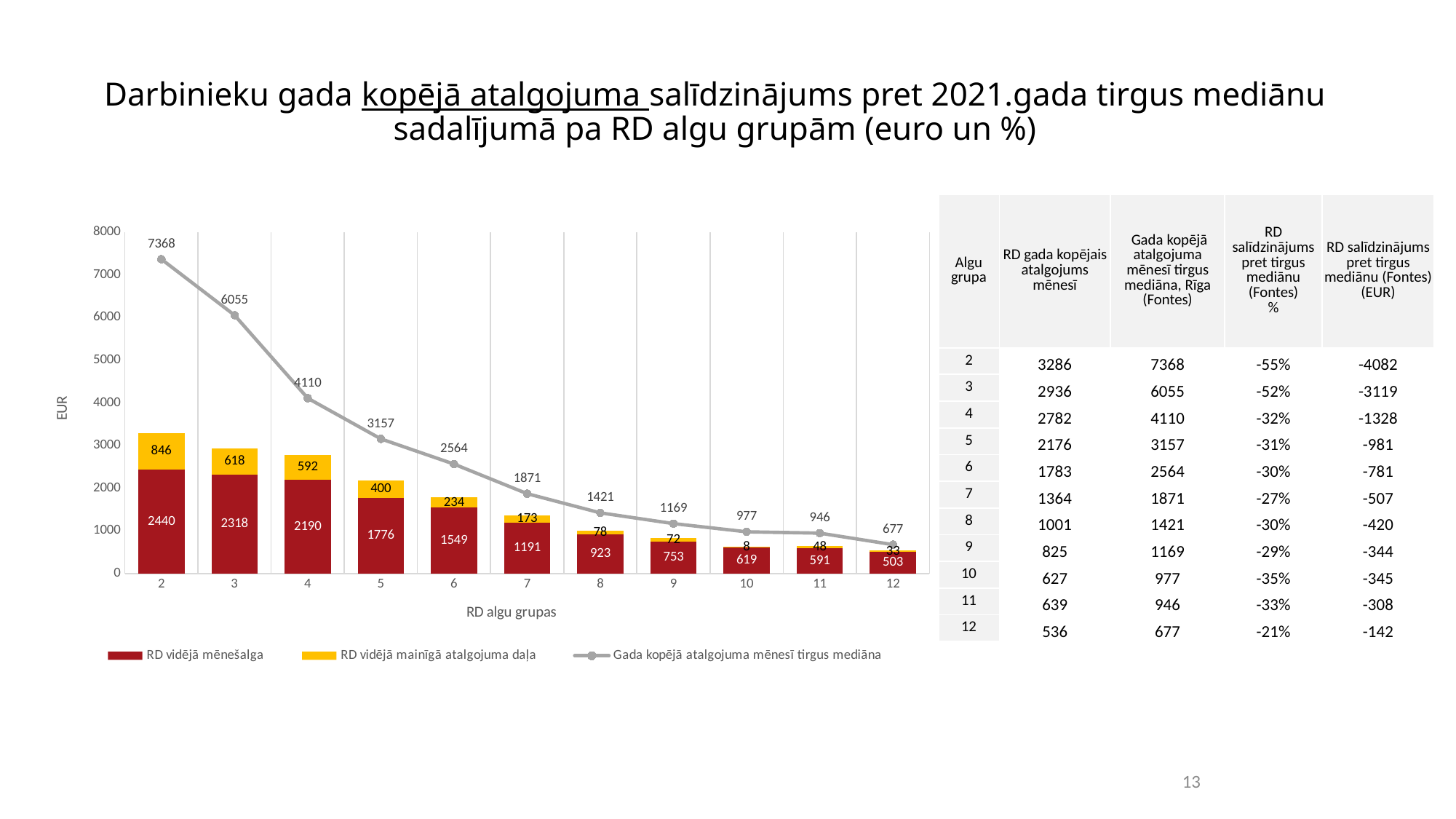
Does the Gada kopējā atalgojuma mēnesī tirgus mediāna rise or fall as the RD algu grupa number increases? fall What is the Gada kopējā atalgojuma mēnesī tirgus mediāna for RD algu grupa 7? 1871 What is the value of RD vidējā mainīgā atalgojuma daļa for RD algu grupa 4? 592 How many RD algu grupas are shown on the x axis of the chart? 11 What is the difference between the Gada kopējā atalgojuma mēnesī tirgus mediāna for grupa 2 and grupa 3? 1313 Which RD algu grupa has the lowest RD vidējā mēnešalga? 12 What is the total of the stacked bar for RD algu grupa 2? 3286 Which is larger, the RD vidējā mainīgā atalgojuma daļa for grupa 3 or for grupa 4? grupa 3 What kind of chart is shown on the slide? stacked bar chart with a line Which RD algu grupa has the highest Gada kopējā atalgojuma mēnesī tirgus mediāna? 2 How many series does the chart legend list? 3 What is the value of RD vidējā mēnešalga for RD algu grupa 5? 1776